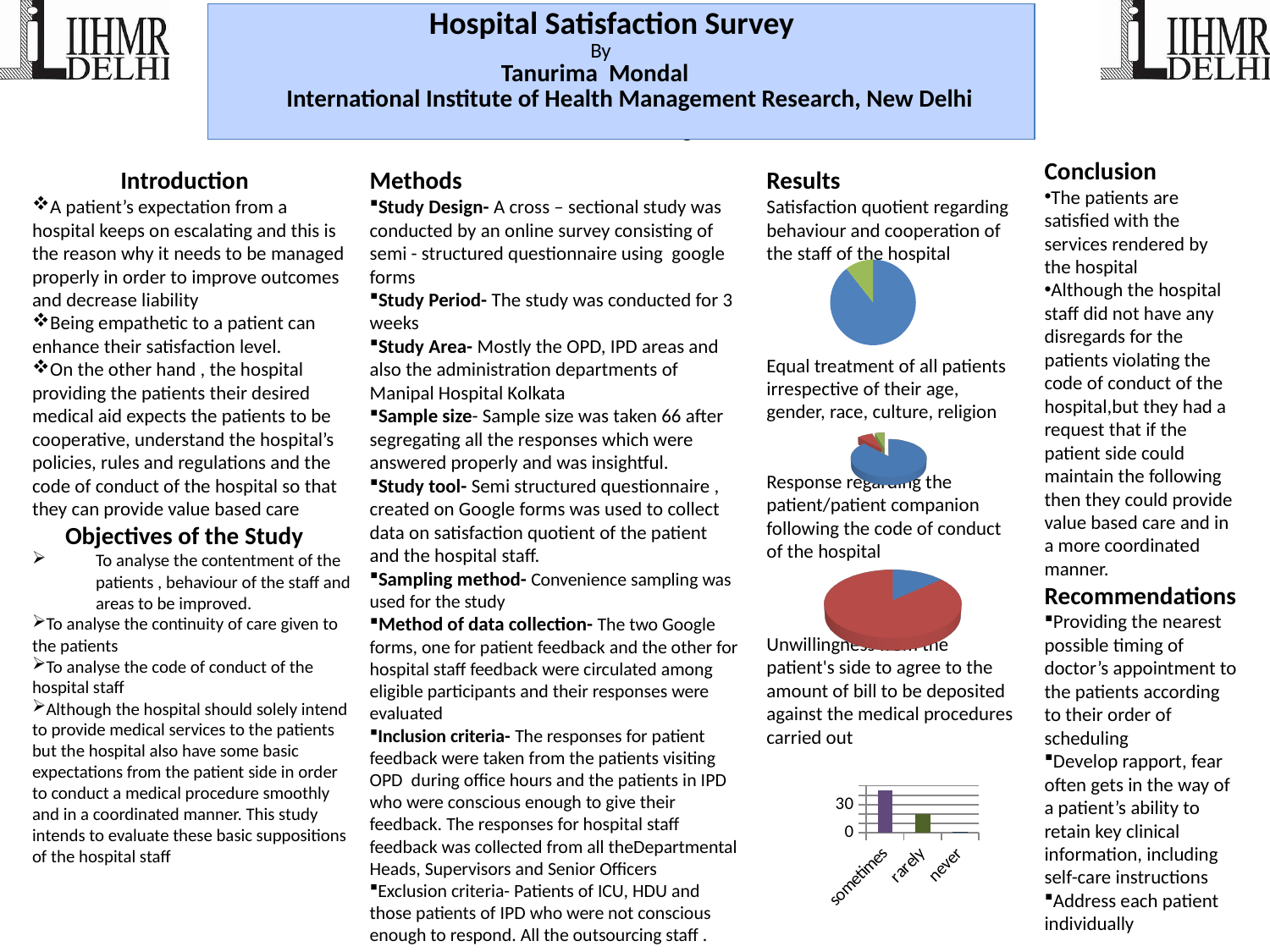
In the bar chart at the bottom of the Results column, is the value for rarely greater or less than 30? less In the bar chart at the bottom of the Results column, which category has the lowest value? never What kind of chart is the chart at the bottom of the Results column, with categories sometimes, rarely and never? bar chart In the bar chart at the bottom of the Results column, which is larger, the value for sometimes or the value for rarely? sometimes In the bar chart at the bottom of the Results column, which category has the highest value? sometimes In the bar chart at the bottom of the Results column, is the value for sometimes greater or less than 30? greater In the pie chart under 'Response regarding the patient/patient companion following the code of conduct of the hospital', what colour is the largest slice? red What kind of chart is the chart under the heading 'Satisfaction quotient regarding behaviour and cooperation of the staff of the hospital'? pie chart How many slices does the pie chart under 'Satisfaction quotient regarding behaviour and cooperation of the staff of the hospital' have? 2 In the bar chart at the bottom of the Results column, do the values rise or fall from left to right along the x axis? fall What are the category labels on the x axis of the bar chart at the bottom of the Results column? sometimes, rarely, never In the bar chart at the bottom of the Results column, how many categories are shown on the x axis? 3